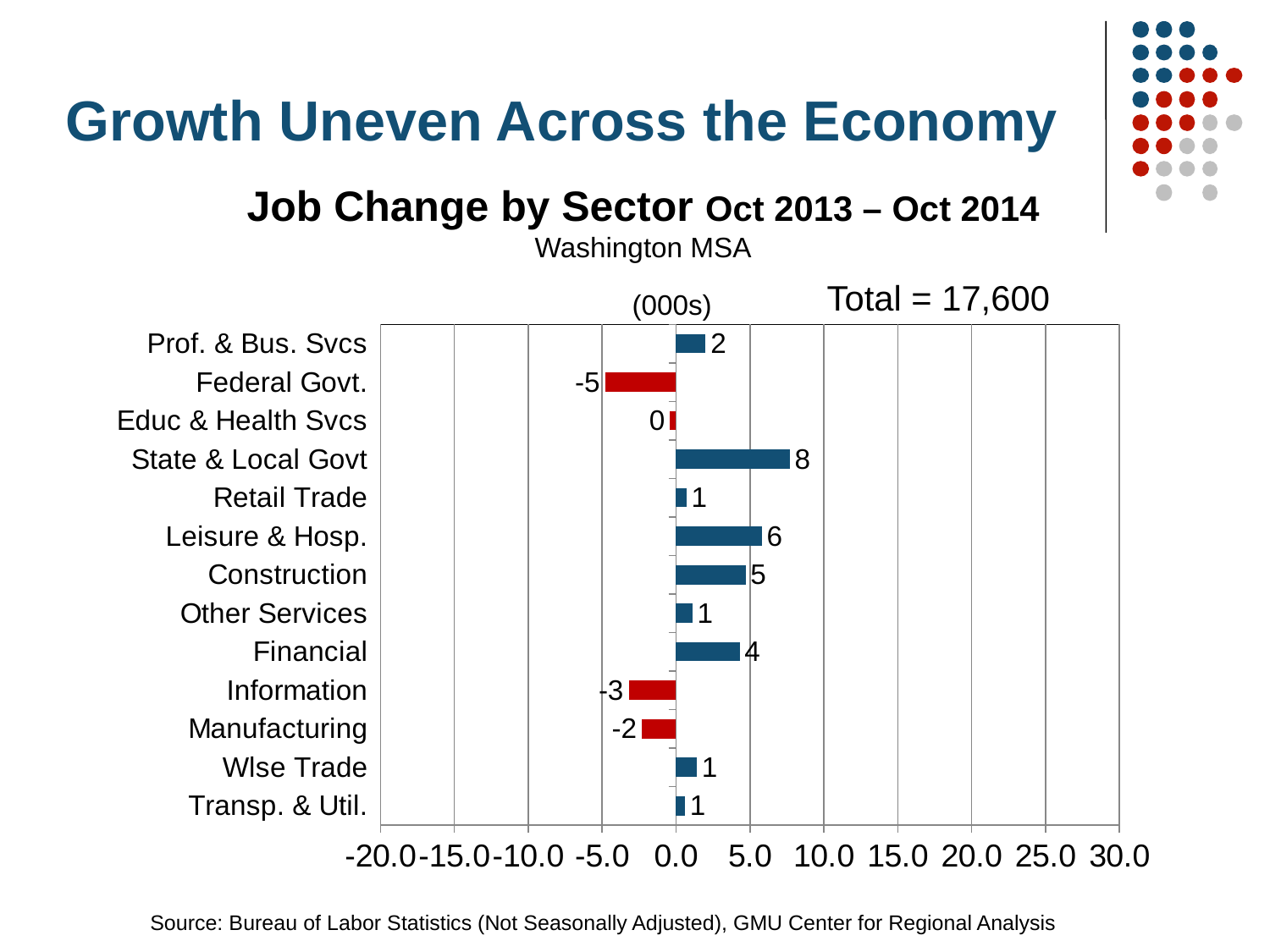
What is the job change value shown for State & Local Govt? 8 What is the job change value shown for Leisure & Hosp.? 6 How many sectors are shown in the chart? 13 What kind of chart is shown on the slide? bar chart Is the value for Federal Govt. greater or less than 0.0? less What is the job change value shown for Federal Govt.? -5 What total is stated above the chart? Total = 17,600 Which sector has the highest job change? State & Local Govt Which has a larger job change, Financial or Leisure & Hosp.? Leisure & Hosp. What is the job change value shown for Information? -3 What is the difference between the job change for State & Local Govt and Construction? 3 Which sector has the lowest job change? Federal Govt.